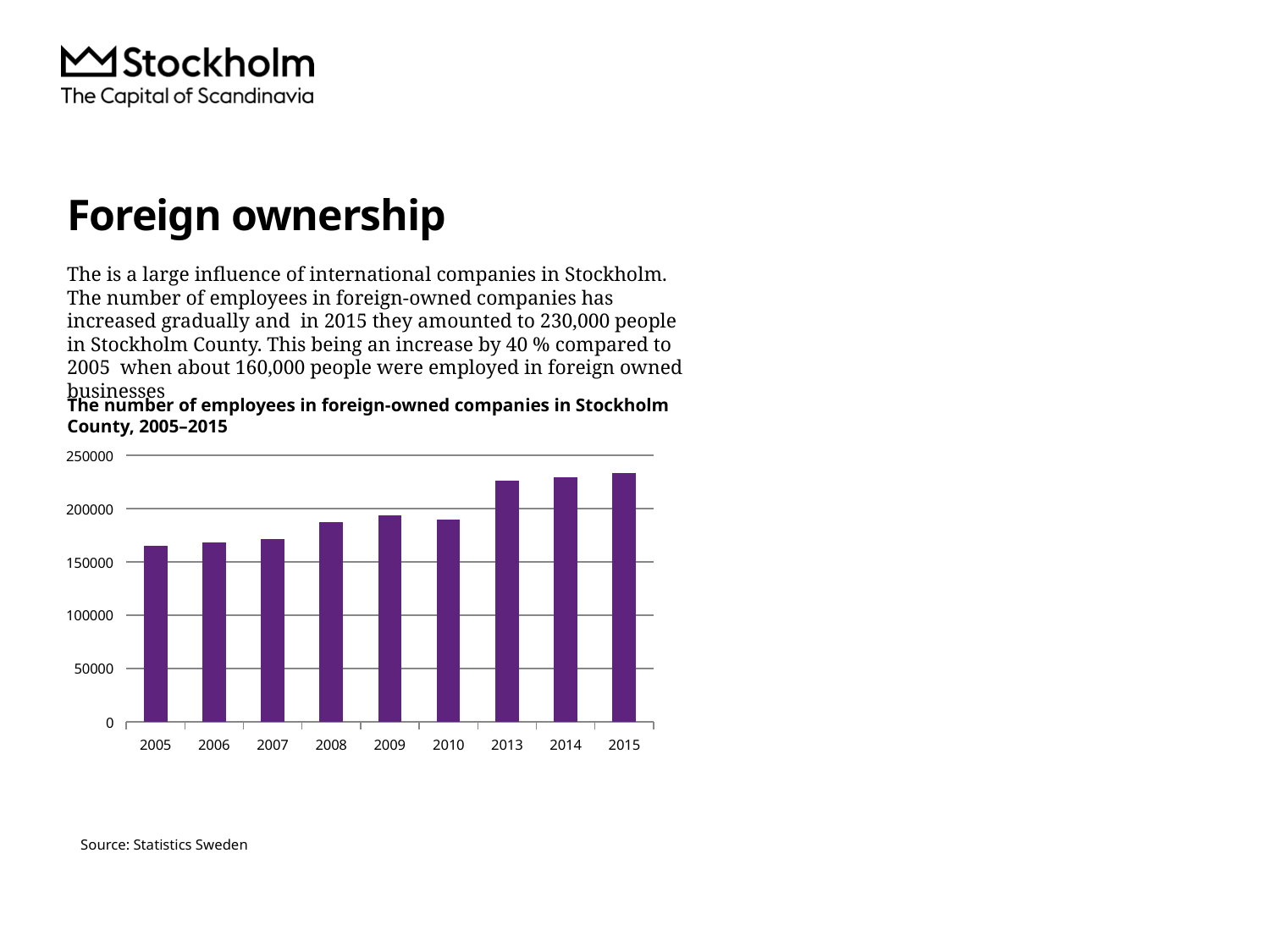
Is the value for 2005 greater or less than 150000? greater What is the title of the chart? The number of employees in foreign-owned companies in Stockholm County, 2005–2015 Which year has the larger value, 2010 or 2013? 2013 Is the value for 2007 greater or less than 200000? less Do the values generally rise or fall from 2005 to 2015? Rise Which year has the larger value, 2005 or 2008? 2008 Is the value for 2010 greater or less than 200000? less How many years are shown on the x axis of the chart? 9 What kind of chart is shown on the slide? Bar chart What is the source cited below the chart? Statistics Sweden